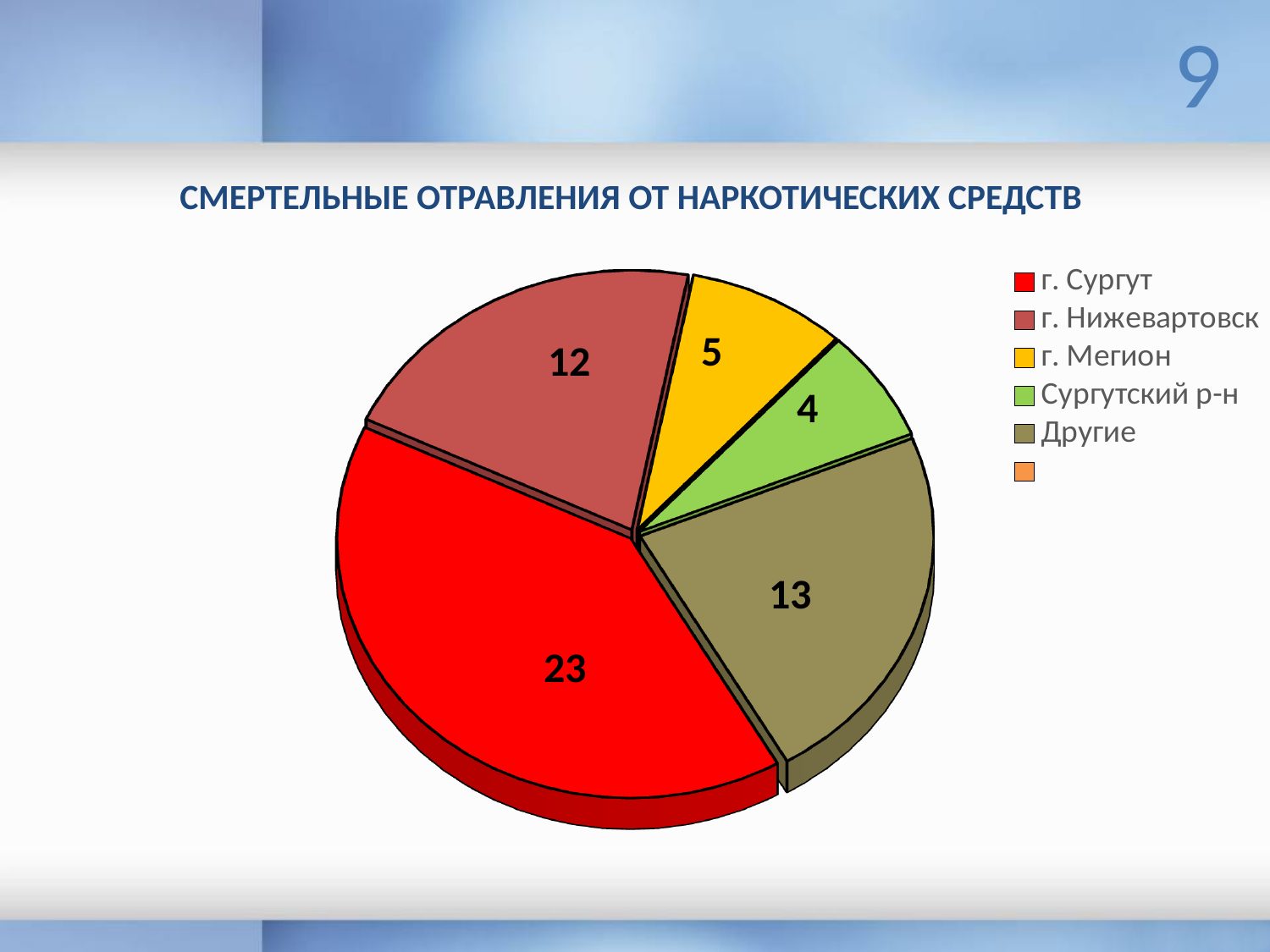
What is the title of the chart? СМЕРТЕЛЬНЫЕ ОТРАВЛЕНИЯ ОТ НАРКОТИЧЕСКИХ СРЕДСТВ What is the value for г. Сургут? 23 What kind of chart is shown on the slide? pie chart How many slices with data labels does the pie chart have? 5 Which category has the smallest slice of the pie? Сургутский р-н What is the value for г. Мегион? 5 What is the value for Другие? 13 What is the difference between the values for г. Сургут and Другие? 10 What is the value for г. Нижевартовск? 12 What is the value for Сургутский р-н? 4 Which is larger, the value for г. Нижевартовск or the value for Другие? Другие Which category has the largest slice of the pie? г. Сургут